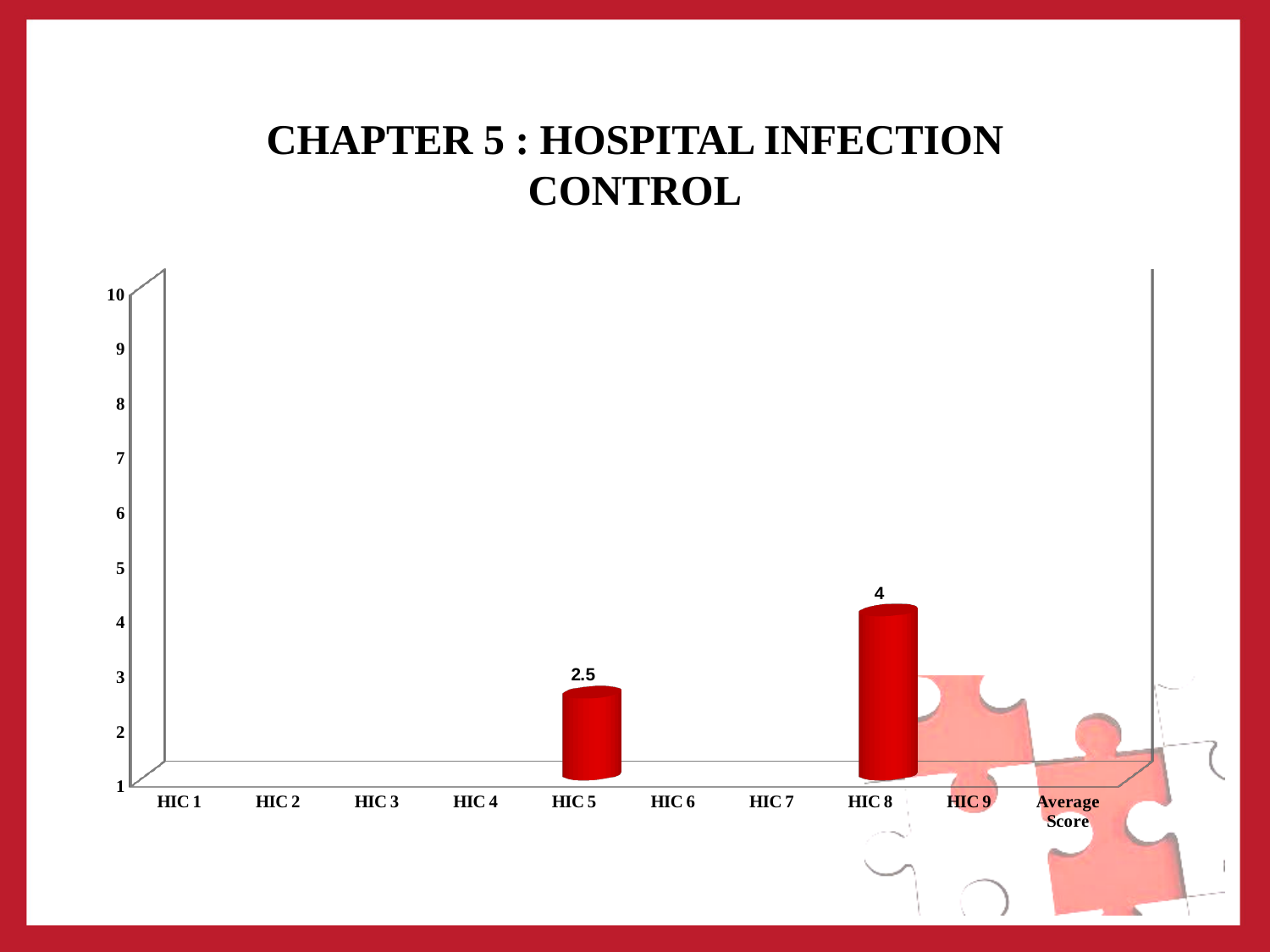
What kind of chart is shown on the slide? Bar chart What is the difference between the values for HIC 8 and HIC 5? 1.5 What is the highest value shown on the y axis? 10 Which category has the tallest bar? HIC 8 How many categories are labelled on the x axis? 10 Is the value for HIC 8 greater or less than 3? greater What is the value for HIC 5? 2.5 What is the value for HIC 8? 4 How many categories have a visible bar plotted? 2 Is the value for HIC 5 greater or less than 3? less Which is larger, the value for HIC 5 or the value for HIC 8? HIC 8 What is the title of the slide containing the chart? CHAPTER 5 : HOSPITAL INFECTION CONTROL